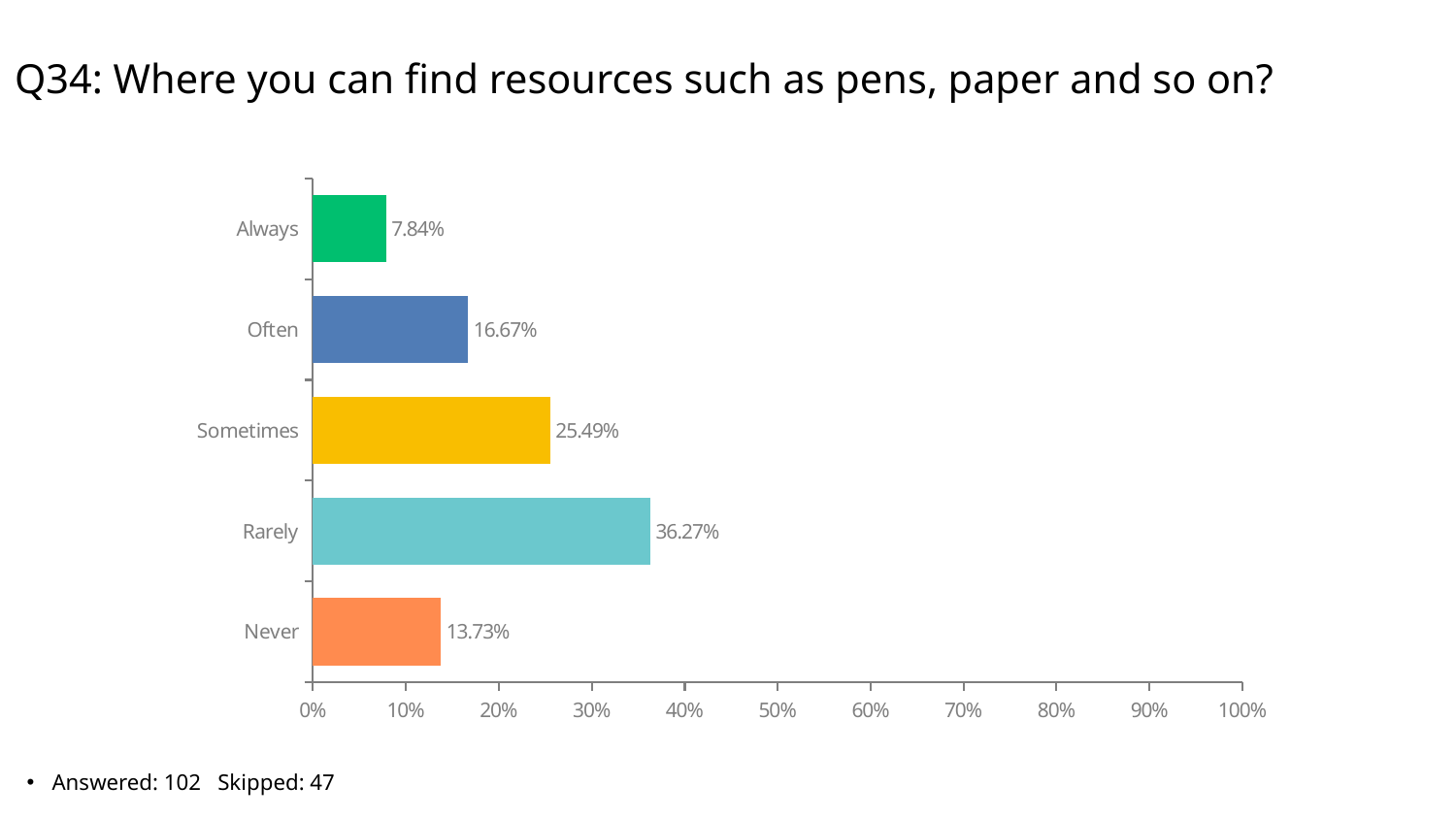
What is the title of the chart? Q34: Where you can find resources such as pens, paper and so on? What kind of chart is shown on the slide? Bar chart What percentage of respondents answered "Rarely"? 36.27% Which category has the lowest percentage? Always Which category has the highest percentage? Rarely Which is larger, the value for "Often" or the value for "Never"? Often What is the value shown for "Always"? 7.84% What percentage is shown for "Sometimes"? 25.49% Is the value for "Rarely" greater or less than 30%? greater What is the difference between the "Often" and "Always" percentages? 8.83% How many categories are shown in the chart? 5 What is the difference between the "Rarely" and "Sometimes" percentages? 10.78%